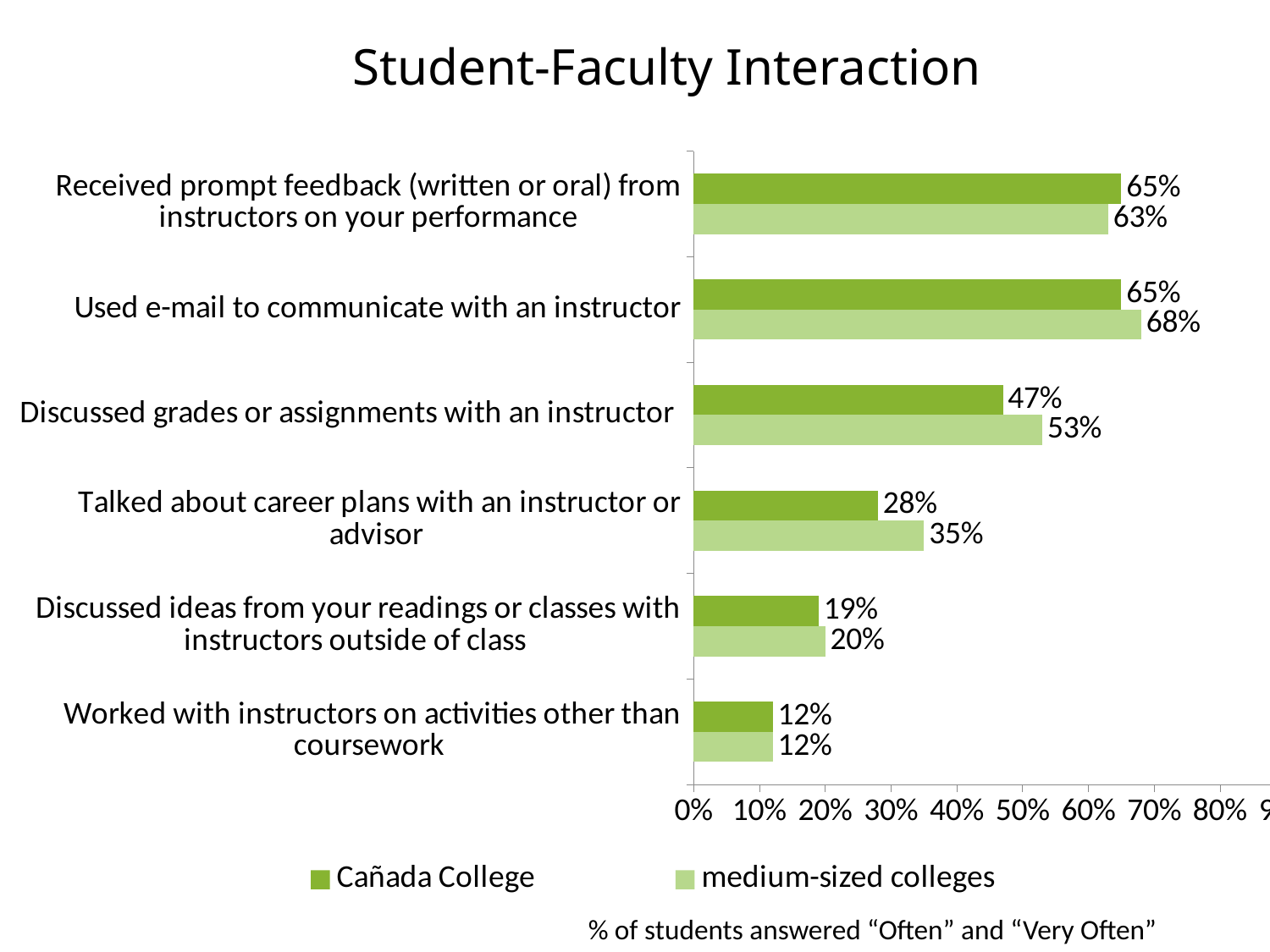
Which category has the highest medium-sized colleges value? Used e-mail to communicate with an instructor What is the difference between the medium-sized colleges and Cañada College values for "Talked about career plans with an instructor or advisor"? 7% What is the medium-sized colleges value for "Discussed grades or assignments with an instructor"? 53% What is the Cañada College value for "Used e-mail to communicate with an instructor"? 65% What is the title of the chart? Student-Faculty Interaction Which category has the lowest Cañada College value? Worked with instructors on activities other than coursework For "Discussed grades or assignments with an instructor", which series has the larger value, Cañada College or medium-sized colleges? medium-sized colleges Is the Cañada College value for "Received prompt feedback (written or oral) from instructors on your performance" greater or less than 60%? greater What kind of chart is shown on the slide? bar chart How many series does the legend list? 2 What is the medium-sized colleges value for "Talked about career plans with an instructor or advisor"? 35% How many categories are shown on the chart? 6